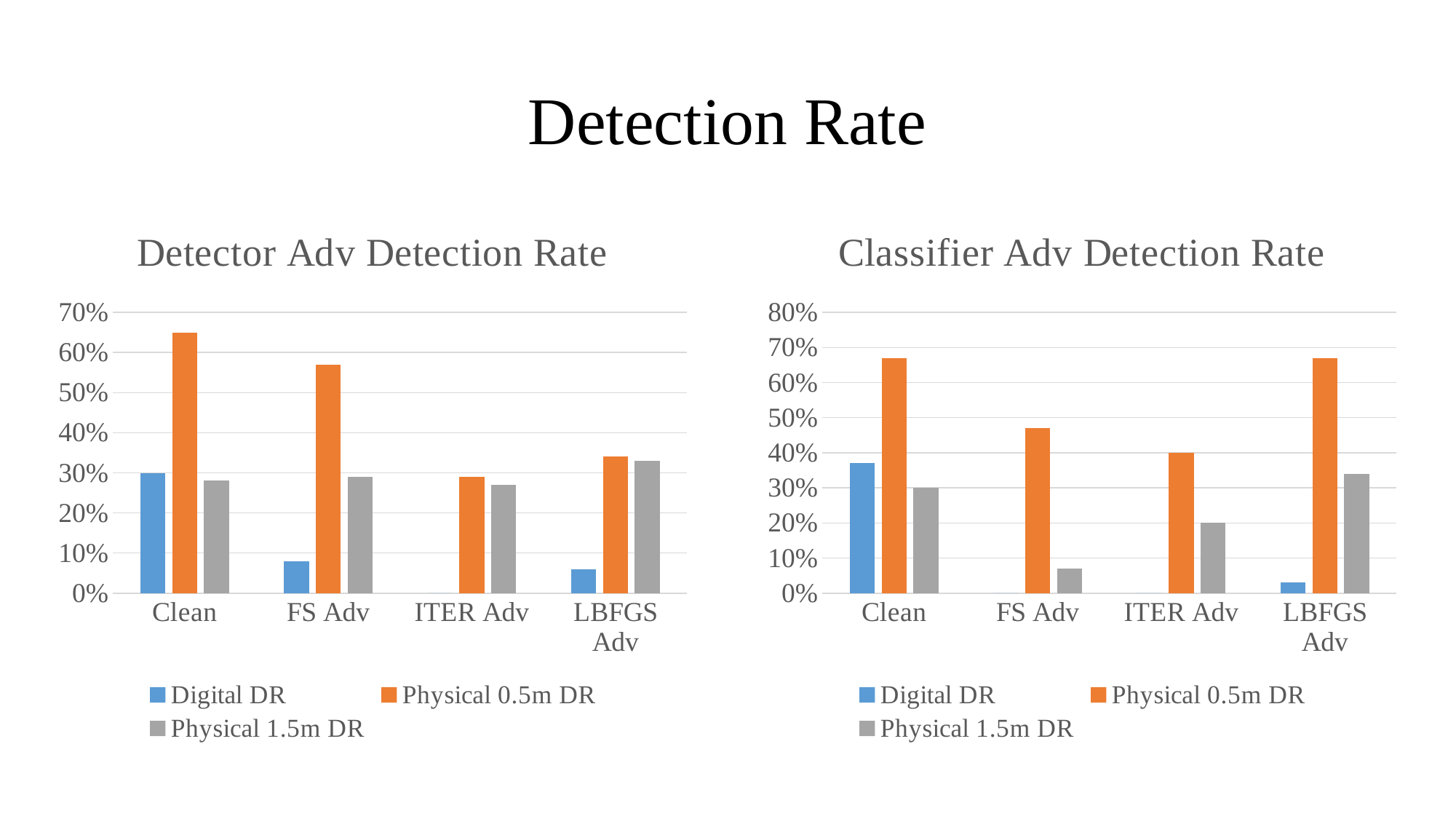
In the Detector Adv Detection Rate chart, which is larger for FS Adv: Physical 0.5m DR or Physical 1.5m DR? Physical 0.5m DR In the Detector Adv Detection Rate chart, is the Physical 0.5m DR value for Clean greater or less than 60%? greater How many categories are shown on the x axis of the Detector Adv Detection Rate chart? 4 In the Classifier Adv Detection Rate chart, which category has the lowest Physical 1.5m DR value? FS Adv In the Classifier Adv Detection Rate chart, which is larger for Clean: Digital DR or Physical 0.5m DR? Physical 0.5m DR Which series is shown in orange in both charts? Physical 0.5m DR In the Detector Adv Detection Rate chart, which category has the highest Physical 0.5m DR value? Clean How many series does the legend of the Classifier Adv Detection Rate chart list? 3 In the Classifier Adv Detection Rate chart, is the Digital DR value for LBFGS Adv greater or less than 10%? less What type of chart is the Detector Adv Detection Rate chart? bar chart In the Classifier Adv Detection Rate chart, is the Physical 0.5m DR value for FS Adv greater or less than 50%? less What is the title of the chart on the right side of the slide? Classifier Adv Detection Rate